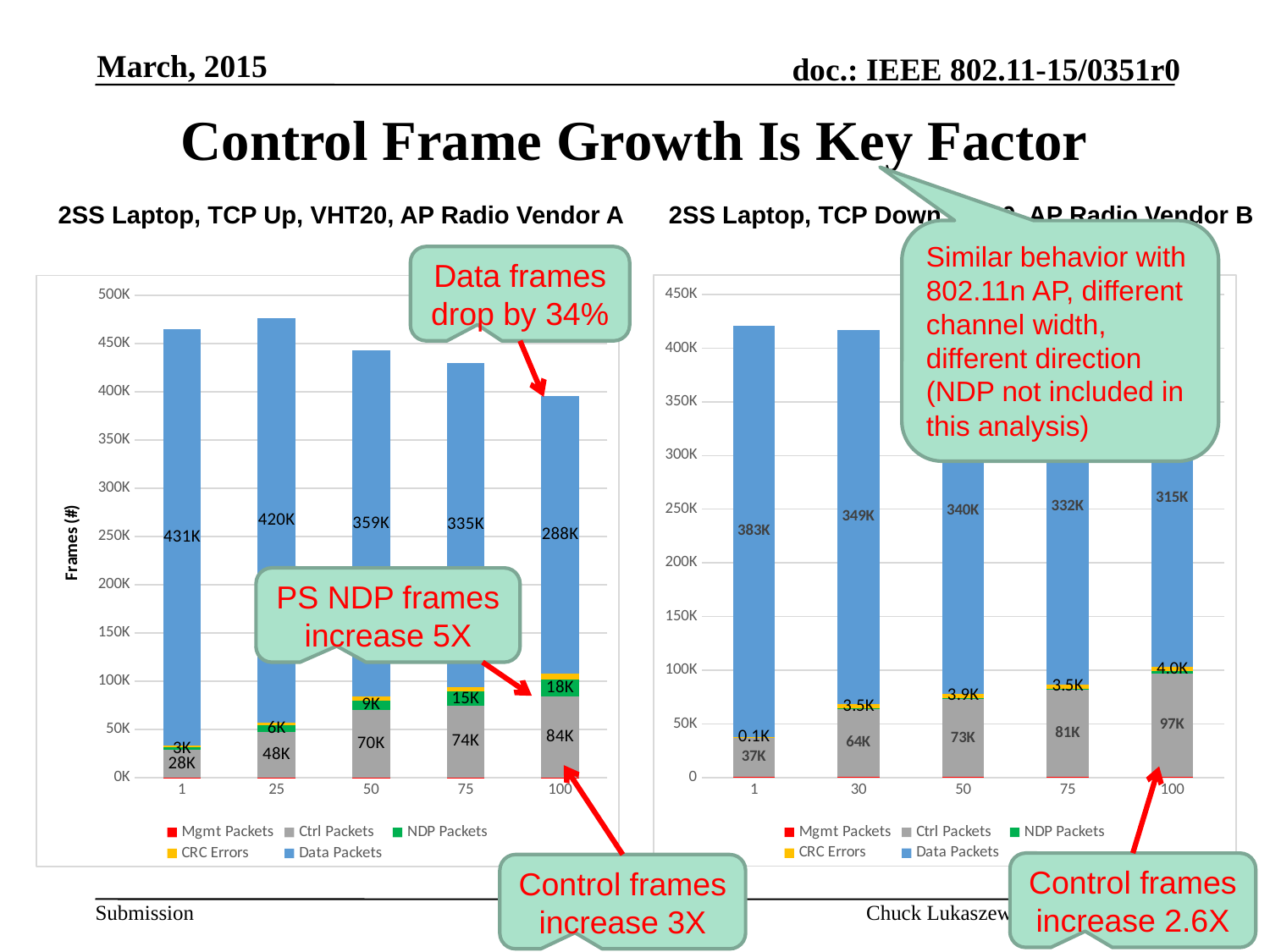
In the left chart (AP Radio Vendor A), what is the Ctrl Packets value at x = 100? 84K In the left chart (2SS Laptop, TCP Up, VHT20, AP Radio Vendor A), what is the Data Packets value at x = 1? 431K In the right chart (AP Radio Vendor B), what is the difference between the Data Packets value at x = 1 and at x = 100? 68K In the right chart (AP Radio Vendor B), at which x-axis category is the Data Packets value lowest? 100 How many series does the legend of the left chart list? 5 In the right chart (AP Radio Vendor B), what is the Ctrl Packets value at x = 75? 81K In the left chart (AP Radio Vendor A), do the Ctrl Packets values rise or fall as x increases from 1 to 100? rise In the right chart (AP Radio Vendor B), what is the Data Packets value at x = 1? 383K In the right chart (AP Radio Vendor B), is the total height of the stacked bar at x = 1 greater or less than 400K? greater In the left chart (AP Radio Vendor A), which is larger: the NDP Packets value at x = 75 or at x = 100? 100 In the left chart (AP Radio Vendor A), what is the difference between the Ctrl Packets value at x = 100 and at x = 1? 56K In the left chart (AP Radio Vendor A), at which x-axis category is the Data Packets value highest? 1